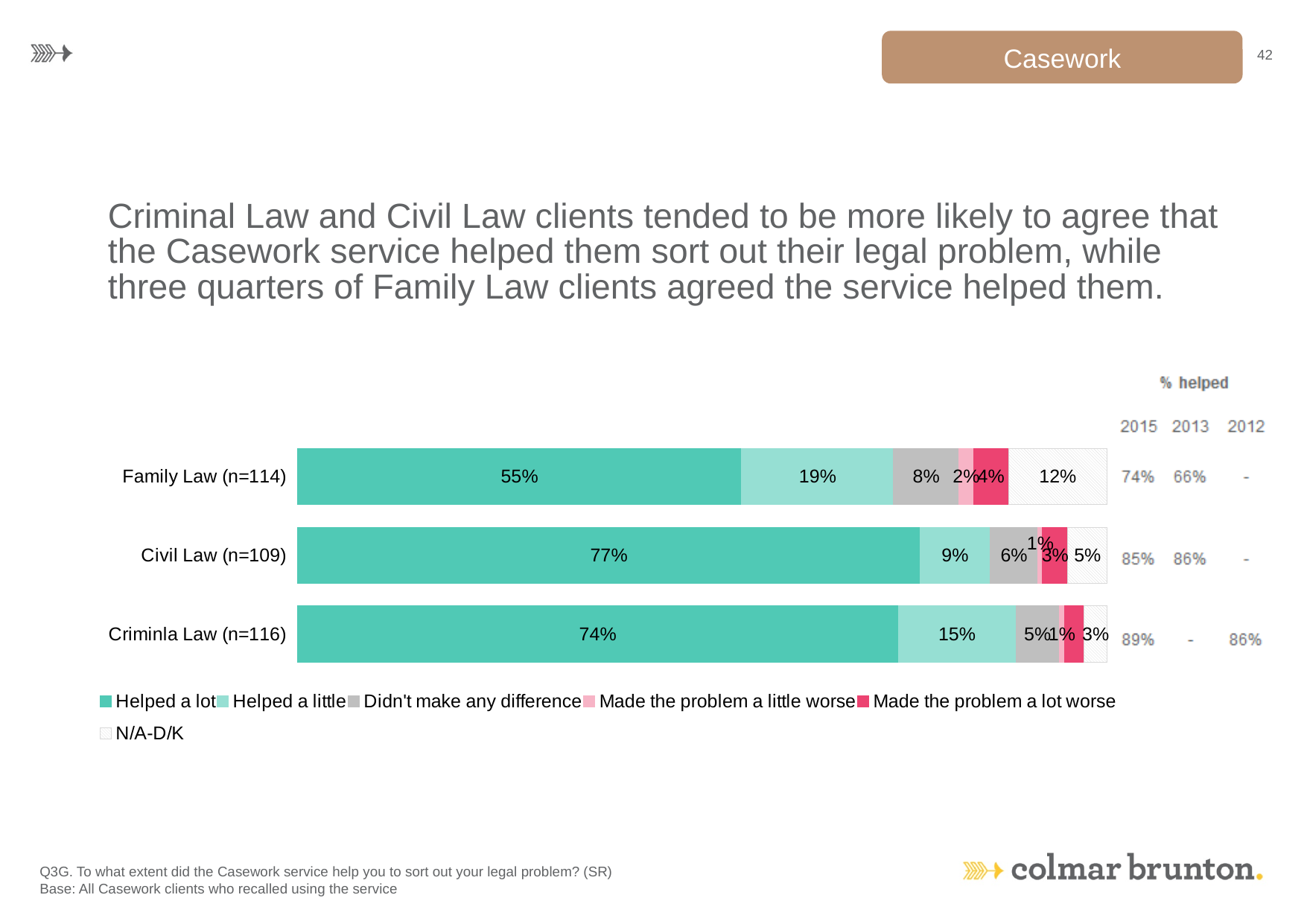
Which is larger: the 'Helped a little' percentage for Family Law or for Criminal Law? Family Law Which law type has the lowest 'Helped a lot' percentage? Family Law (n=114) What percentage of Family Law clients said the Casework service 'Helped a lot'? 55% How many categories (law types) are plotted in the chart? 3 What percentage of Civil Law clients said the service 'Helped a little'? 9% Which law type has the highest 'Helped a lot' percentage? Civil Law (n=109) How many series does the chart legend list? 6 What kind of chart is shown on the slide? Stacked bar chart What is the difference between the 'Helped a lot' percentages for Civil Law and Family Law? 22 percentage points In the '% helped' table, what is the 2015 value for Criminal Law? 89% What percentage of Criminal Law clients said the service 'Didn't make any difference'? 5% What is the N/A-D/K percentage for Family Law? 12%